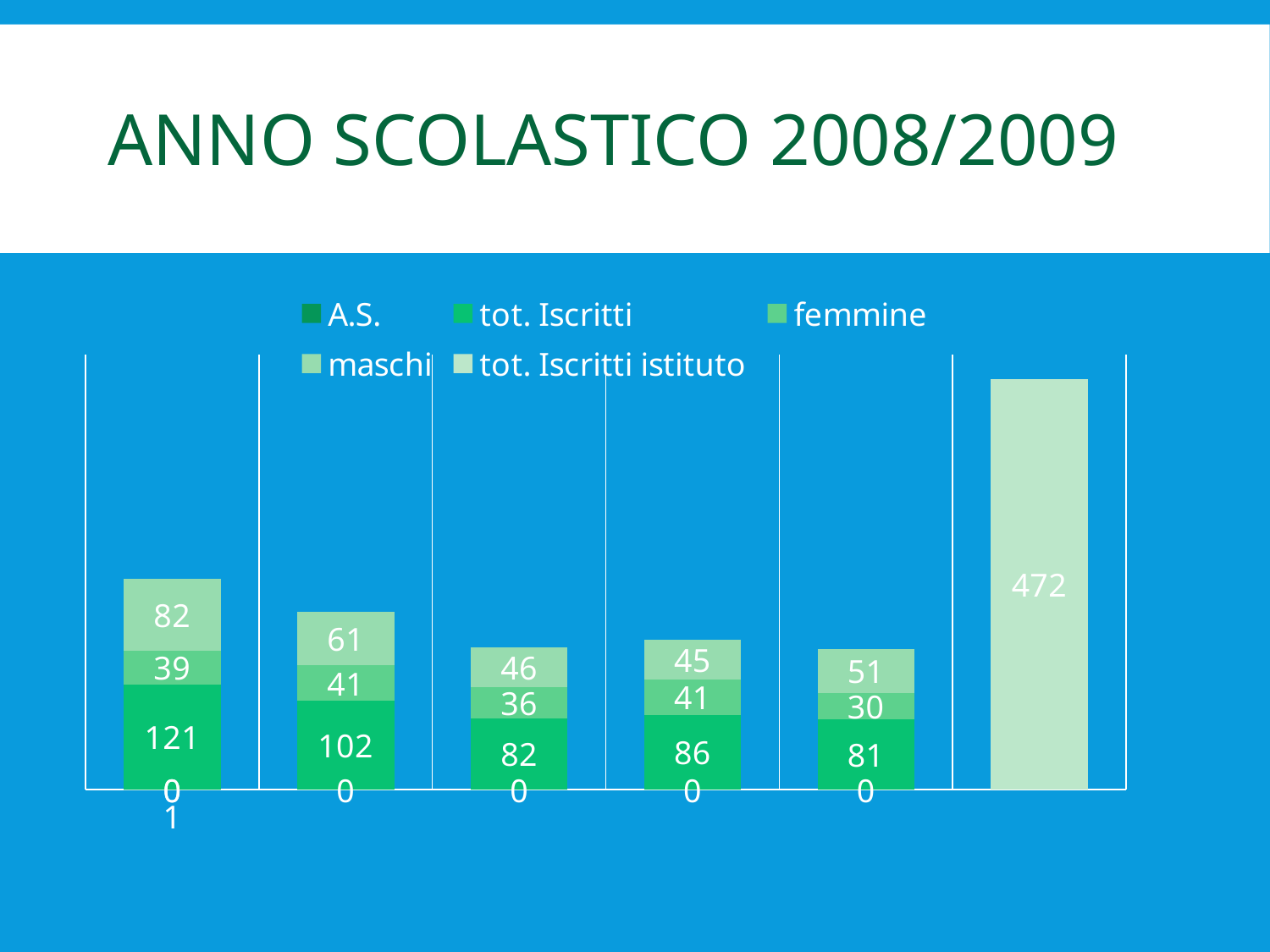
What is the femmine value in the fifth stacked bar? 30 What is the title of the slide containing the chart? ANNO SCOLASTICO 2008/2009 Is the maschi value larger in the second stacked bar or in the third stacked bar? the second bar (61) What is the A.S. value shown for the first bar (category 1)? 0 Which of the five stacked bars has the highest tot. Iscritti value? the first bar (121) In the first bar (category 1), what is the difference between the maschi value and the femmine value? 43 How many series does the legend list? 5 What kind of chart is shown on the slide? bar chart What is the total of the first stacked bar (category 1), summing all its labelled segments? 242 What is the tot. Iscritti value for the first bar (category 1)? 121 What is the value of the tot. Iscritti istituto bar? 472 Which of the five stacked bars has the lowest tot. Iscritti value? the fifth bar (81)